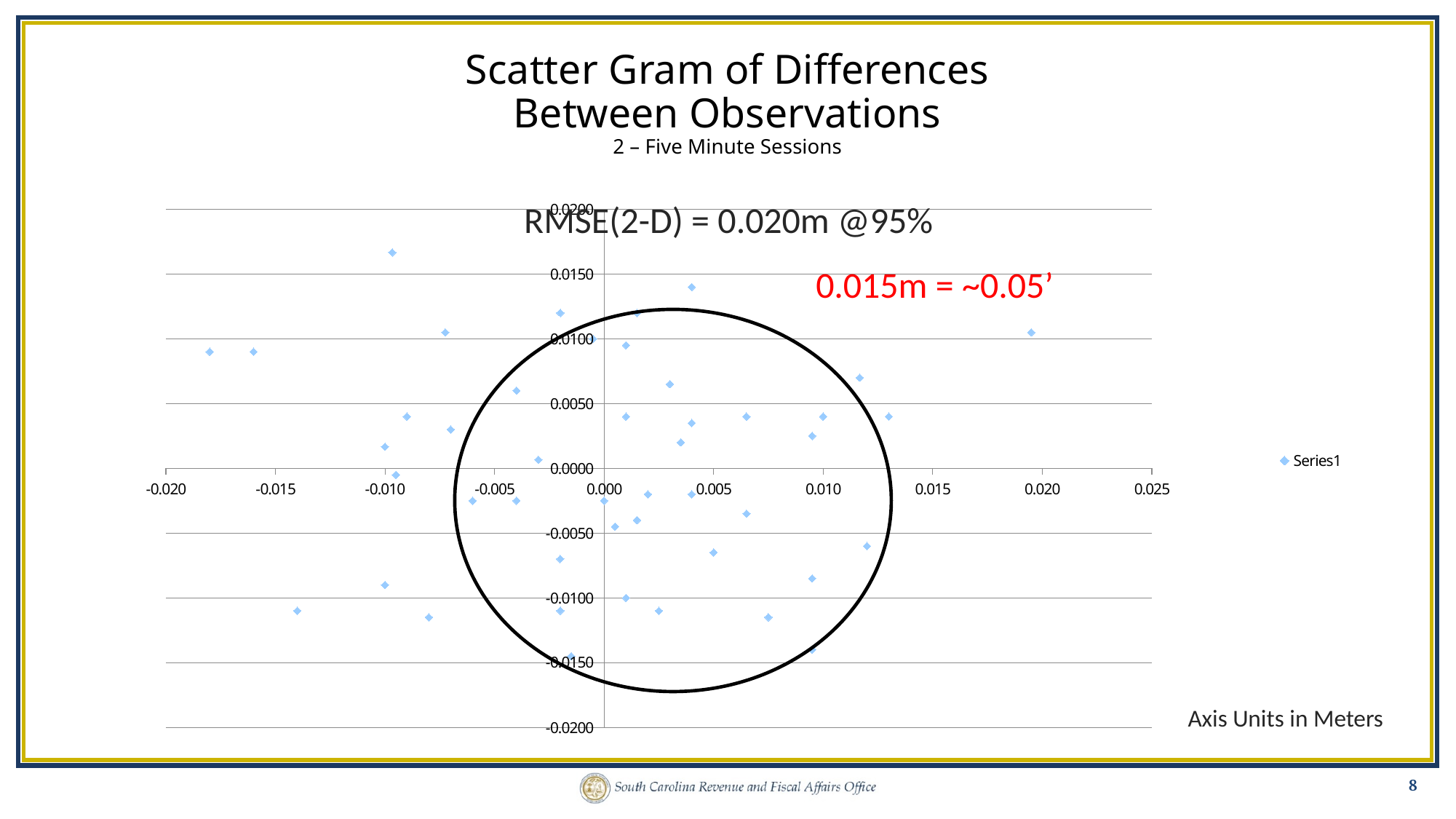
What is the RMSE(2-D) value stated on the chart? 0.020m @95% Is the y value of the highest point greater or less than 0.0150? greater Is the y value of the lowest point greater or less than -0.0100? less Is the x value of the rightmost point greater or less than 0.020? less What kind of chart is shown on the slide? Scatter chart How many series does the legend list? 1 What is the name of the series shown in the legend? Series1